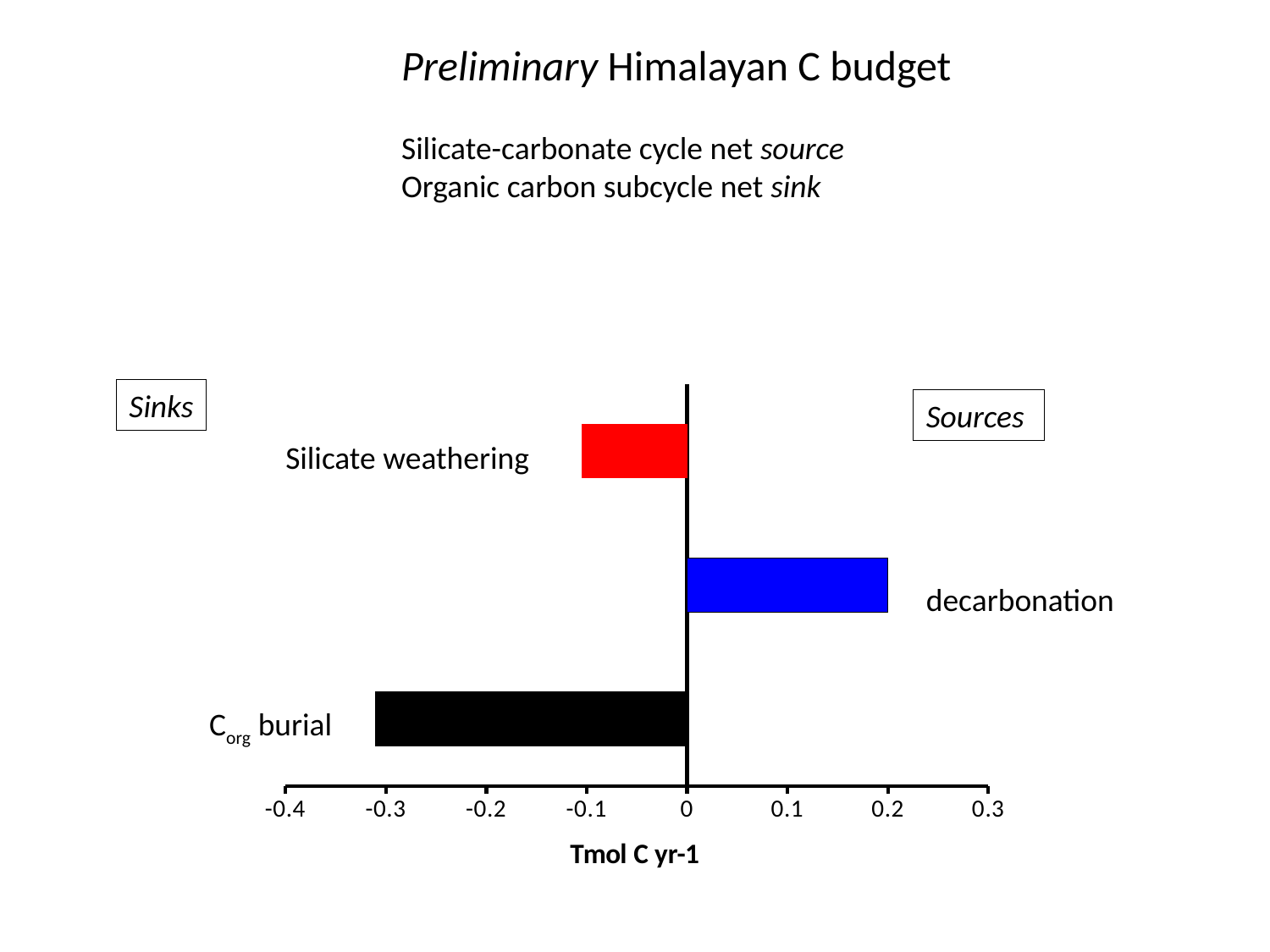
Which category has the highest (most positive) value? decarbonation What is the title of the chart on the slide? Preliminary Himalayan C budget Which bar is longer, Corg burial or Silicate weathering? Corg burial Which category has the lowest (most negative) value? Corg burial What colour is the decarbonation bar? blue What is the value for decarbonation in Tmol C yr-1? 0.2 Which has the larger value, decarbonation or Silicate weathering? decarbonation Is the value for Corg burial greater or less than -0.2? less Is the value for Silicate weathering greater or less than -0.2? greater Is the value for decarbonation greater or less than 0.1? greater How many categories (bars) are plotted in the chart? 3 What kind of chart is shown on the slide? bar chart